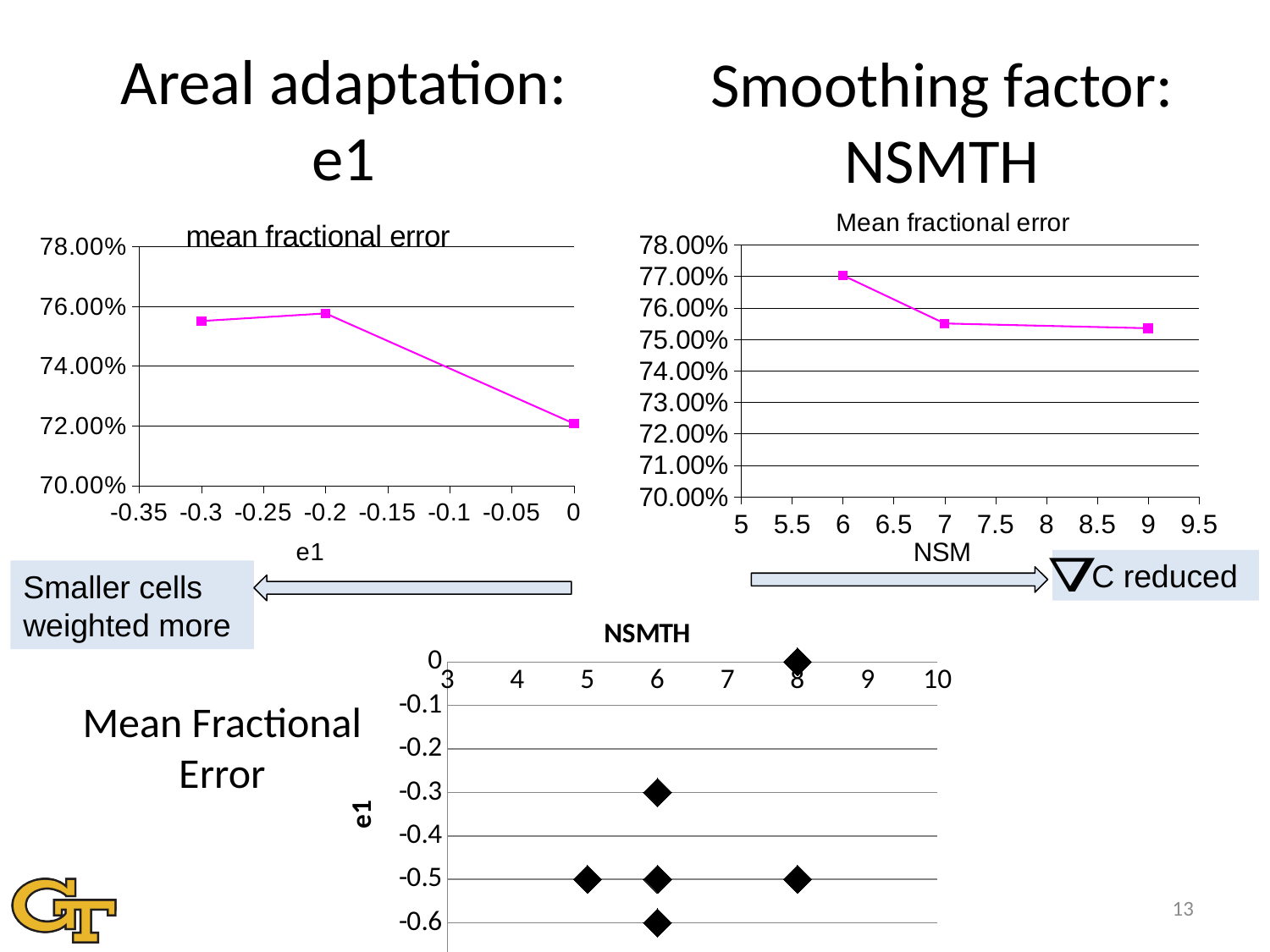
What kind of chart is the bottom chart titled 'NSMTH'? scatter chart In the right chart titled 'Mean fractional error' (x axis NSM), do the values rise or fall as NSM increases? fall In the left chart (x axis e1), at which e1 value is the mean fractional error lowest? 0 In the left chart (x axis e1), is the value at e1 = -0.3 greater or less than 74.00%? greater In the right chart titled 'Mean fractional error', what is the label of the x axis? NSM In the right chart titled 'Mean fractional error' (x axis NSM), at which NSM value is the mean fractional error highest? 6 In the bottom chart titled 'NSMTH', how many points are plotted? 6 In the left chart (x axis e1), is the value at e1 = 0 greater or less than 74.00%? less In the right chart titled 'Mean fractional error' (x axis NSM), is the value at NSM = 6 greater or less than 76.00%? greater In the left chart (x axis e1), how many data points are plotted? 3 What kind of chart is the left chart titled 'mean fractional error'? line chart In the bottom chart titled 'NSMTH', how many points have an e1 value of -0.5? 3